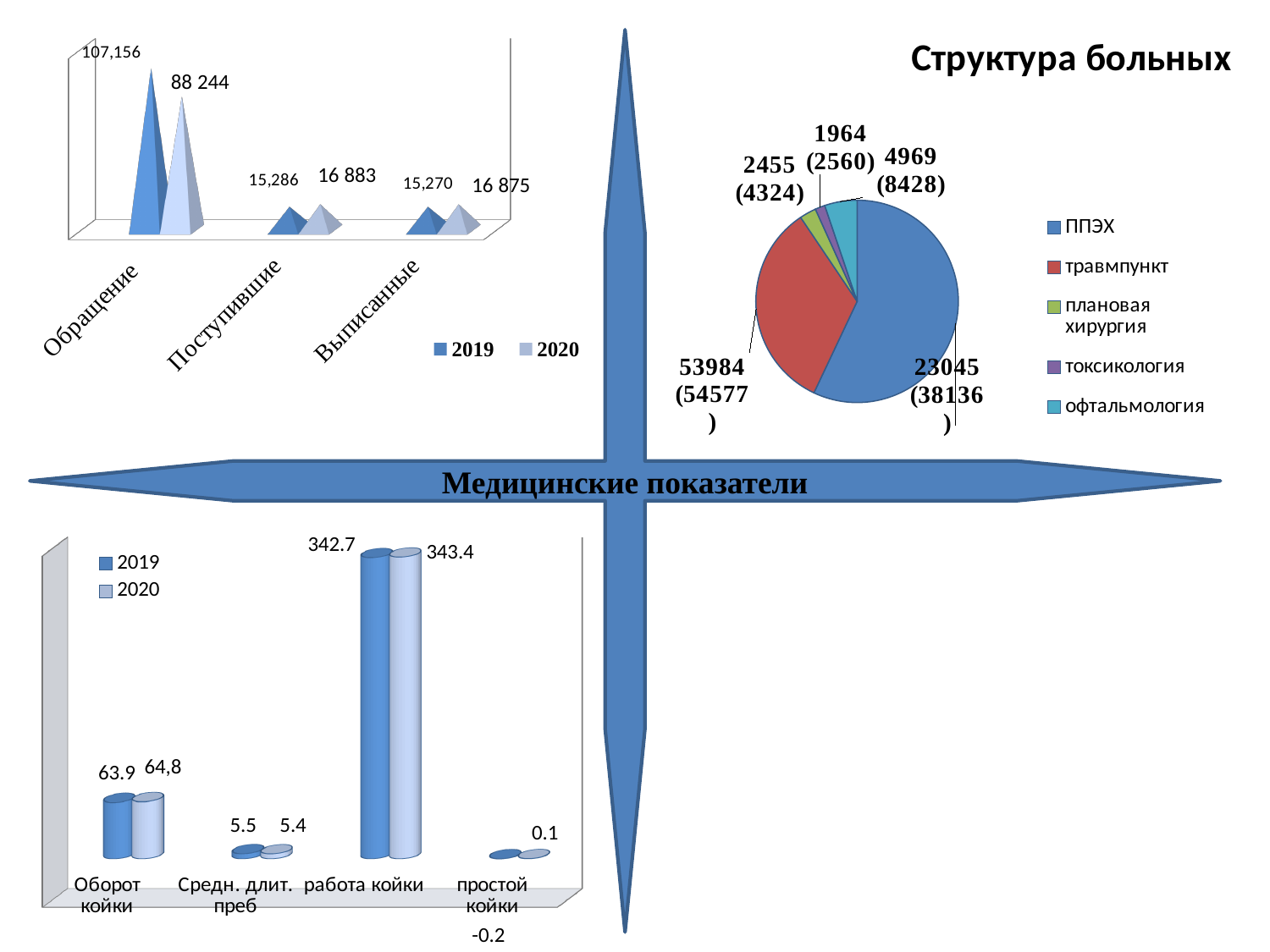
What kind of chart is the bottom-left chart? bar chart In the pie chart Структура больных, what data label is shown for the офтальмология slice? 4969 (8428) In the top-left chart, which category has the highest value for 2019? Обращение In the top-left chart, is the 2019 value for Обращение larger or smaller than the 2020 value? larger In the top-left chart, how many series does the legend list? 2 In the bottom-left chart, what is the value for работа койки in 2020? 343.4 In the top-left chart, what is the value for Поступившие in 2020? 16 883 In the pie chart Структура больных, how many entries does the legend list? 5 In the bottom-left chart, what is the value for простой койки in 2019? -0.2 In the top-left chart, what is the value for Обращение in 2019? 107,156 What is the title of the pie chart on the slide? Структура больных In the top-left chart, how many categories are shown on the x axis? 3